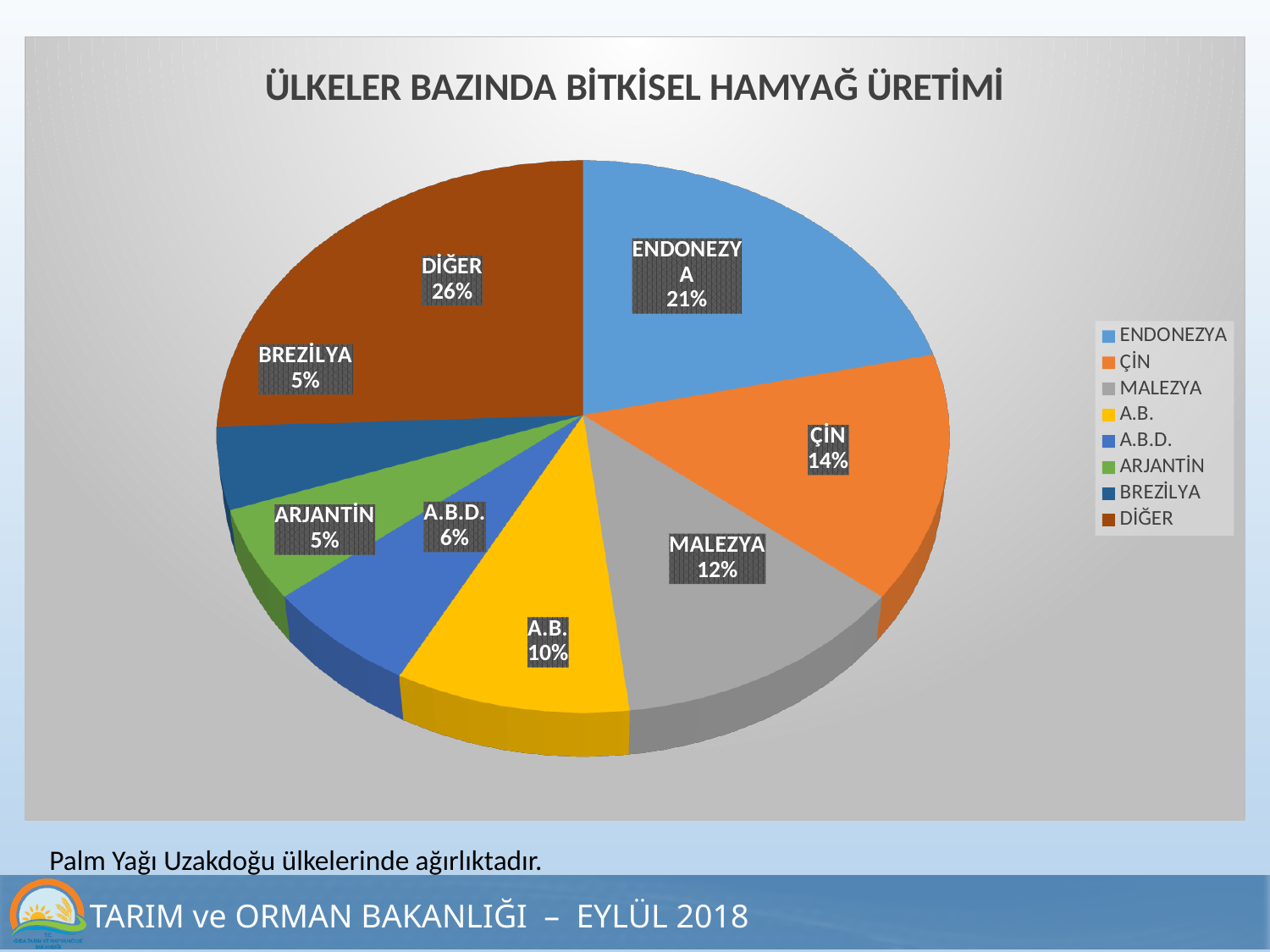
What is the value shown for MALEZYA? 12% What share of the pie does ENDONEZYA hold? 21% Which category has the largest slice of the pie? DİĞER How many categories does the pie chart show? 8 What is the difference in percentage points between ENDONEZYA and ÇİN? 7 What is the value shown for ÇİN? 14% What kind of chart is shown on the slide? Pie chart What is the value shown for A.B.D.? 6% What colour is the DİĞER slice? Brown Which named country has the largest share? ENDONEZYA What is the title of the chart? ÜLKELER BAZINDA BİTKİSEL HAMYAĞ ÜRETİMİ Which is larger, the share for A.B. or the share for A.B.D.? A.B.